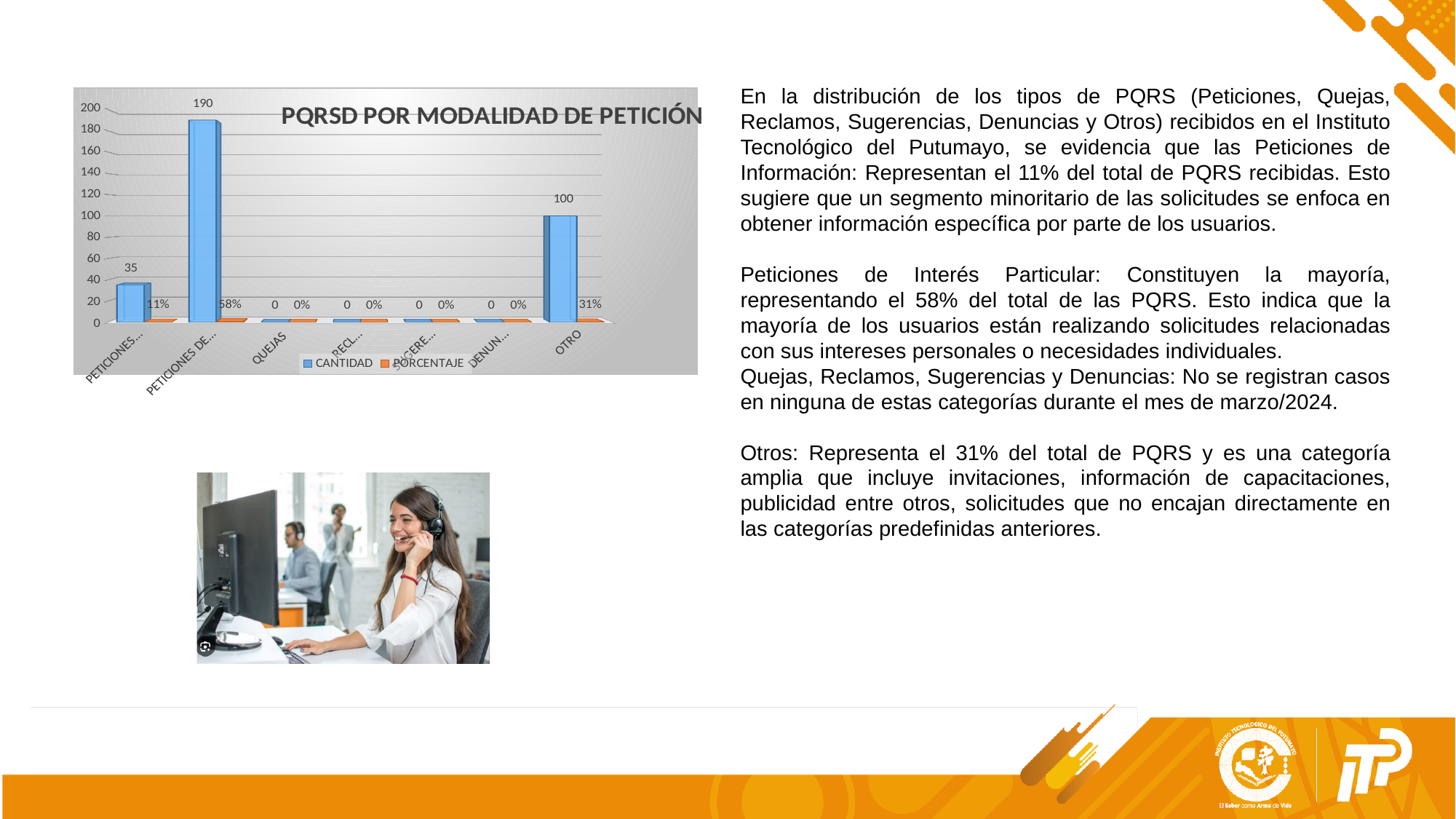
What is the CANTIDAD value for OTRO? 100 What is the CANTIDAD value for QUEJAS? 0 What kind of chart is shown on the slide? bar chart What are the two series named in the chart legend? CANTIDAD and PORCENTAJE What is the title of the chart? PQRSD POR MODALIDAD DE PETICIÓN What is the highest CANTIDAD value shown in the chart? 190 How many series does the chart legend list? 2 What is the highest PORCENTAJE value shown in the chart? 58% Which has a larger CANTIDAD value, OTRO or QUEJAS? OTRO What is the difference between the highest CANTIDAD value (190) and the CANTIDAD value for OTRO? 90 What is the PORCENTAJE value for OTRO? 31% How many categories are shown on the x axis of the chart? 7